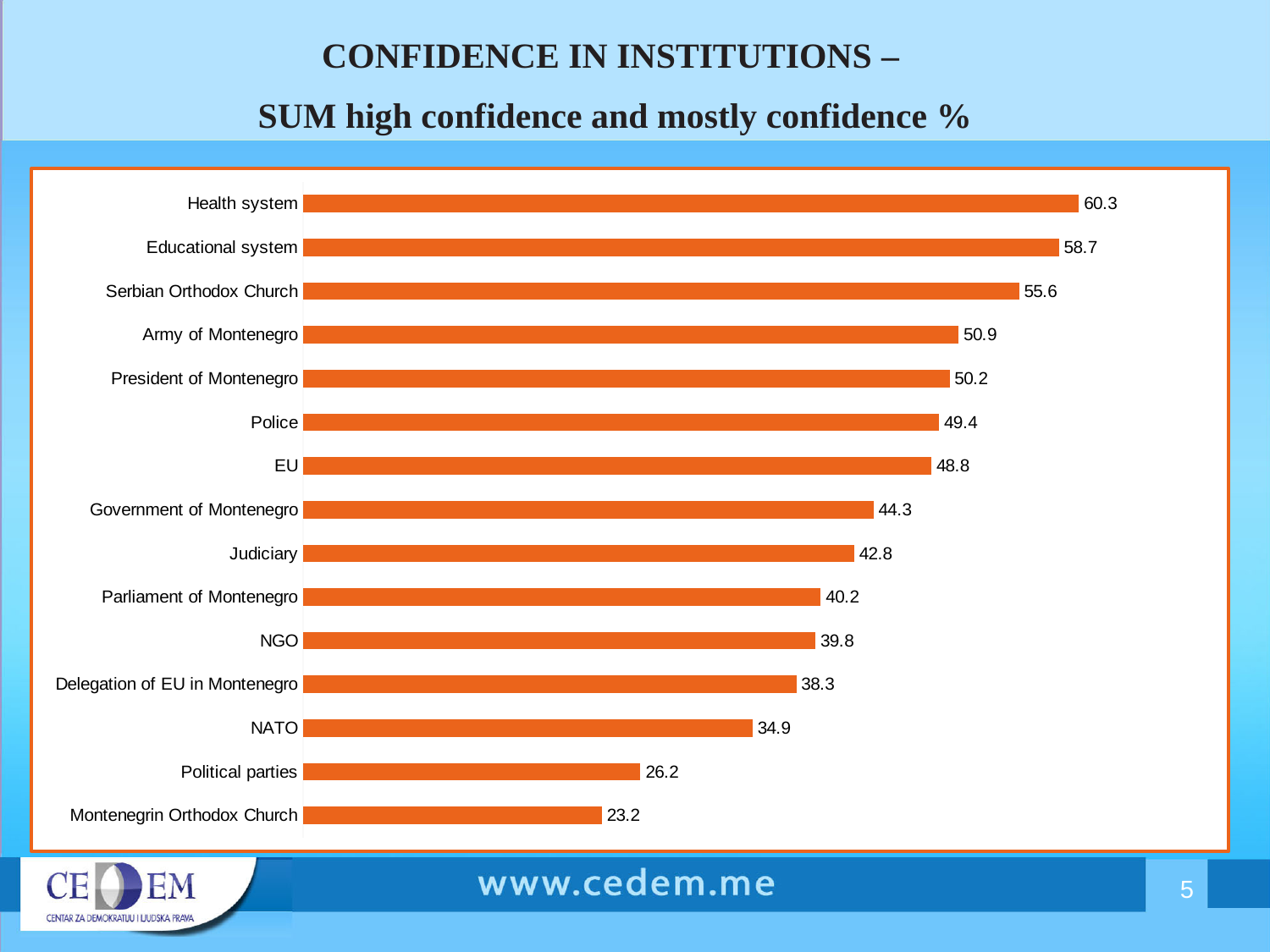
What colour are the bars in the chart? Orange Which institution has the lowest value? Montenegrin Orthodox Church What is the difference between the values for Health system and Montenegrin Orthodox Church? 37.1 Which has a larger value, NGO or EU? EU How many institutions are shown in the chart? 15 What is the value for Health system? 60.3 What is the value for Government of Montenegro? 44.3 What is the value for NATO? 34.9 Which has a larger value, Police or Judiciary? Police What is the difference between the values for Serbian Orthodox Church and Political parties? 29.4 What kind of chart is shown on the slide? Bar chart Which institution has the highest value? Health system